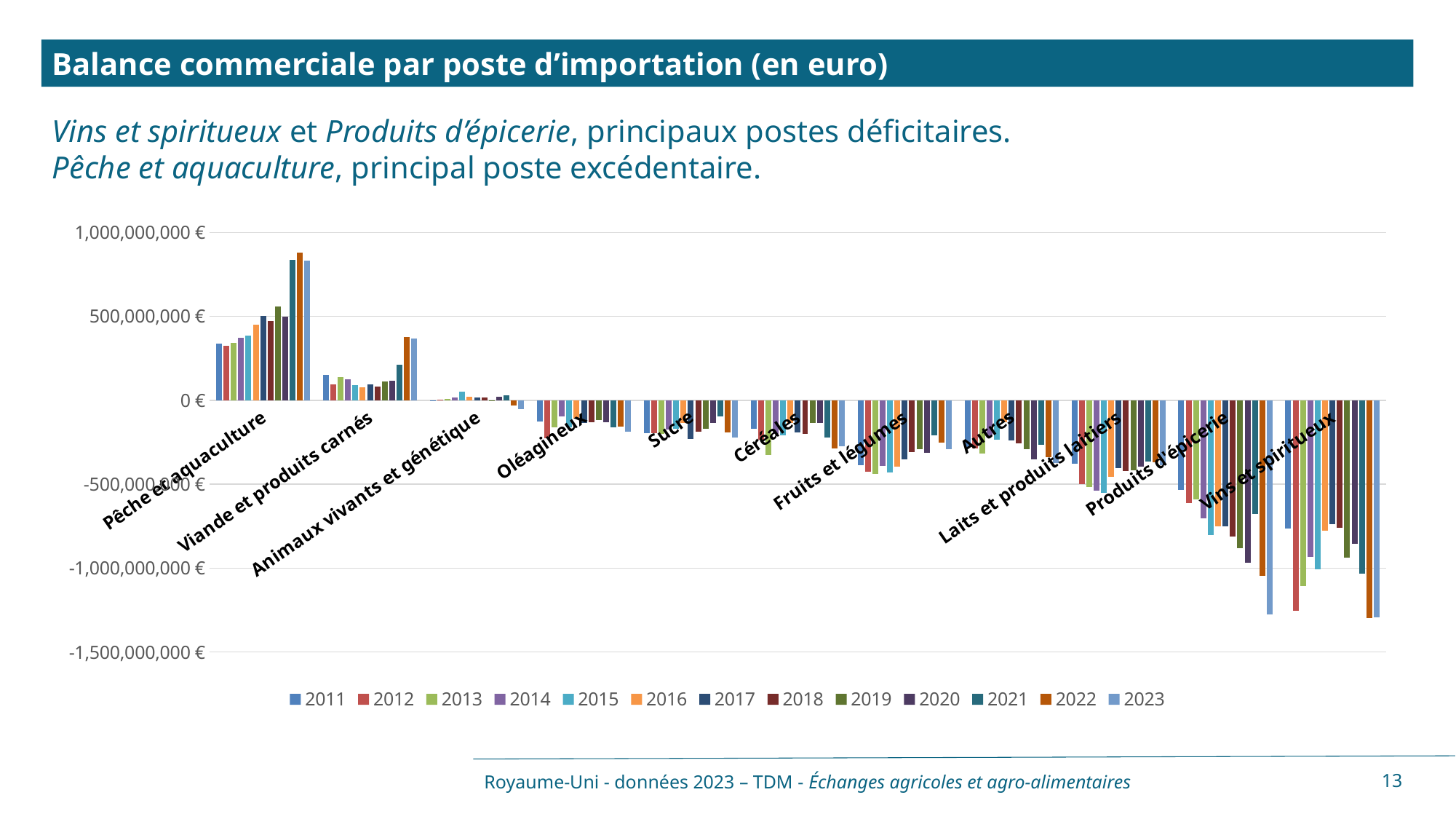
How many import categories are shown on the x axis? 11 Which category has the lowest (most negative) trade balance values? Vins et spiritueux Does the value for Pêche et aquaculture rise or fall overall from 2011 to 2023? rise What kind of chart is shown on the slide? bar chart Is the value for Viande et produits carnés in 2022 greater or less than 500,000,000 €? less What is the title of the chart? Balance commerciale par poste d'importation (en euro) Which is larger in 2023: the value for Pêche et aquaculture or the value for Viande et produits carnés? Pêche et aquaculture Which category has the highest (most positive) trade balance values? Pêche et aquaculture How many series does the legend list? 13 Is the value for Pêche et aquaculture in 2022 greater or less than 500,000,000 €? greater Which is lower in 2023: the value for Laits et produits laitiers or the value for Produits d'épicerie? Produits d'épicerie Is the value for Vins et spiritueux in 2023 greater or less than -1,000,000,000 €? less